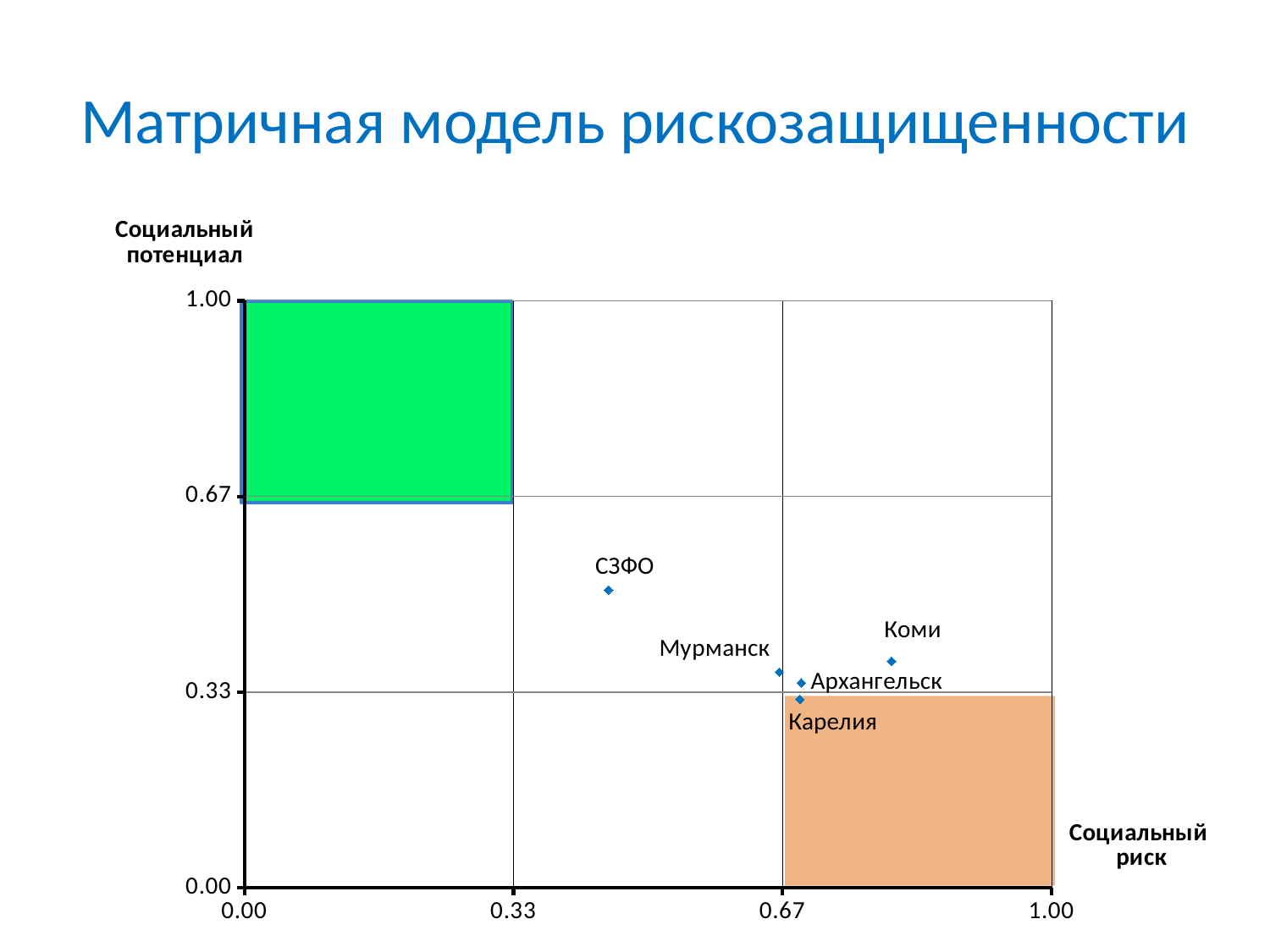
What is the title of the slide? Матричная модель рискозащищенности Which has the larger Социальный потенциал value, СЗФО or Коми? СЗФО What kind of chart is shown on the slide? scatter chart Is the Социальный риск value for СЗФО greater or less than 0.67? less How many labeled data points are plotted on the chart? 5 Is the Социальный потенциал value for СЗФО greater or less than 0.33? greater Is the Социальный риск value for Коми greater or less than 0.67? greater Which region has the lowest value on the Социальный риск (horizontal) axis? СЗФО Which region has the highest value on the Социальный потенциал (vertical) axis? СЗФО Which region has the highest value on the Социальный риск (horizontal) axis? Коми Which has the larger Социальный риск value, Коми or Мурманск? Коми